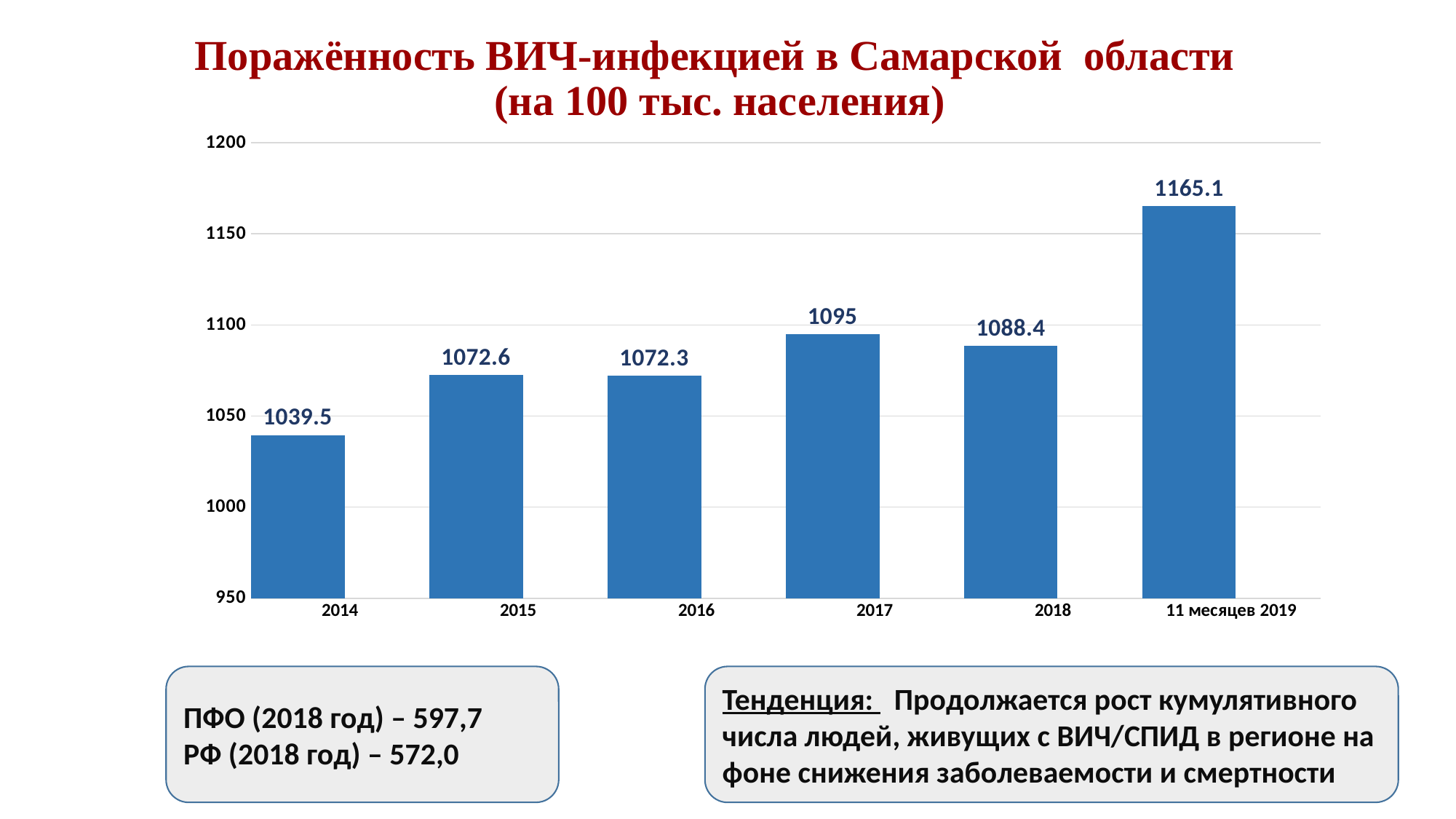
What is the value for 2017? 1095 What is the value for 11 месяцев 2019? 1165.1 What kind of chart is shown on the slide? bar chart How many categories are shown on the x axis? 6 Which is larger, the value for 2017 or the value for 2018? 2017 Which category has the lowest value? 2014 What is the difference between the values for 11 месяцев 2019 and 2018? 76.7 What is the difference between the values for 2017 and 2014? 55.5 Is the value for 2018 greater or less than 1100? less What is the title of the chart? Поражённость ВИЧ-инфекцией в Самарской области (на 100 тыс. населения) Which category has the highest value? 11 месяцев 2019 What is the value for 2014? 1039.5